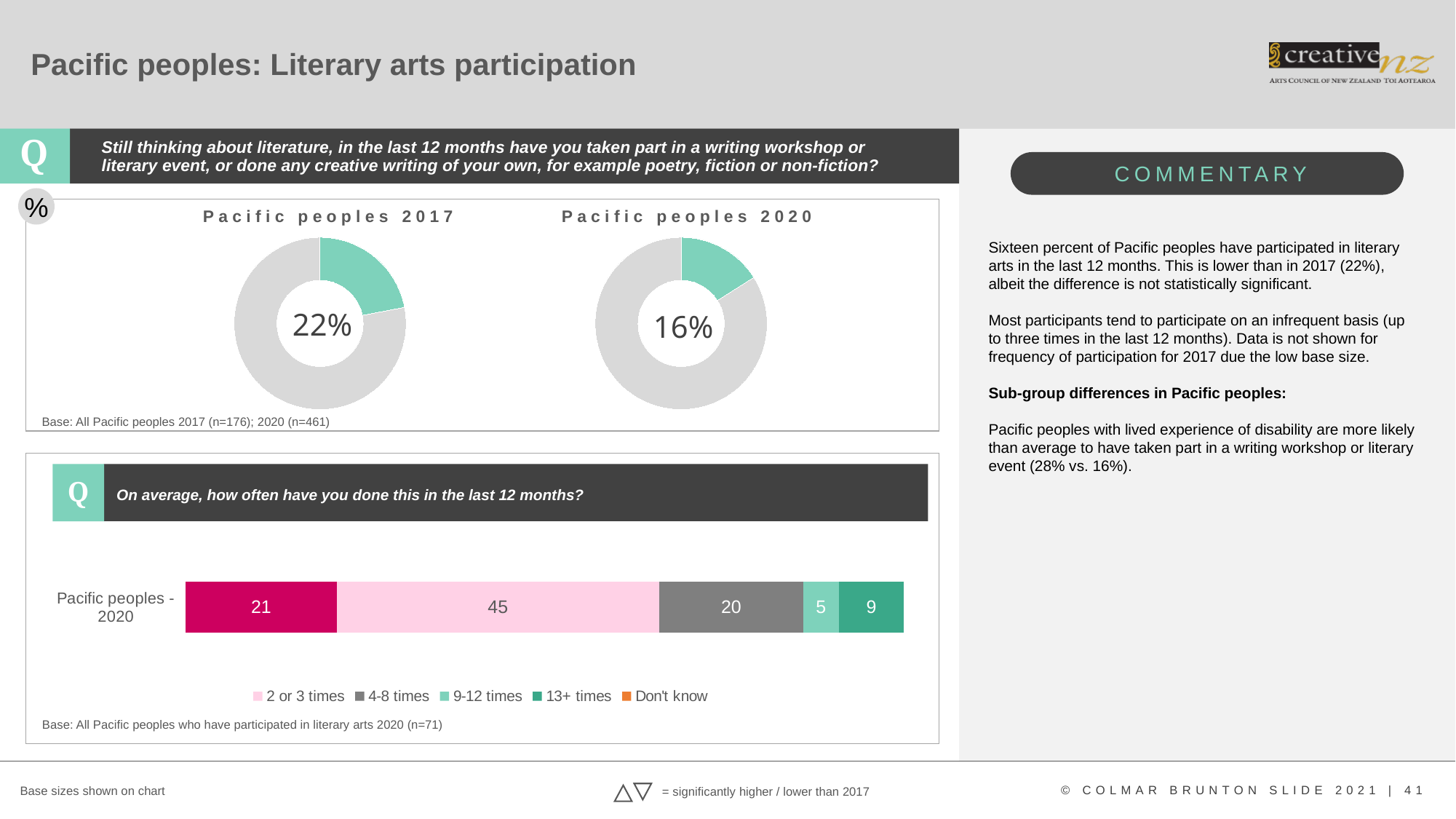
In the 'Pacific peoples 2020' donut chart, what percentage is shown in the centre? 16% What is the difference between the participation rates shown in the 'Pacific peoples 2017' and 'Pacific peoples 2020' donut charts? 6 percentage points In the stacked bar chart for 'Pacific peoples - 2020', what is the value for '2 or 3 times'? 45 What is the total of all segments in the 'Pacific peoples - 2020' stacked bar? 100 How many entries does the legend of the stacked bar chart list? 5 What kind of chart is used for the 'Pacific peoples 2017' and 'Pacific peoples 2020' figures? Pie (donut) chart In the stacked bar chart for 'Pacific peoples - 2020', what is the value for '4-8 times'? 20 In the stacked bar chart for 'Pacific peoples - 2020', what is the value for '9-12 times'? 5 In the stacked bar chart for 'Pacific peoples - 2020', which legend category has the largest segment? 2 or 3 times Comparing the two donut charts, which year shows the higher literary arts participation rate, 2017 or 2020? 2017 In the stacked bar chart for 'Pacific peoples - 2020', what is the value for '13+ times'? 9 In the 'Pacific peoples 2017' donut chart, what percentage is shown in the centre? 22%